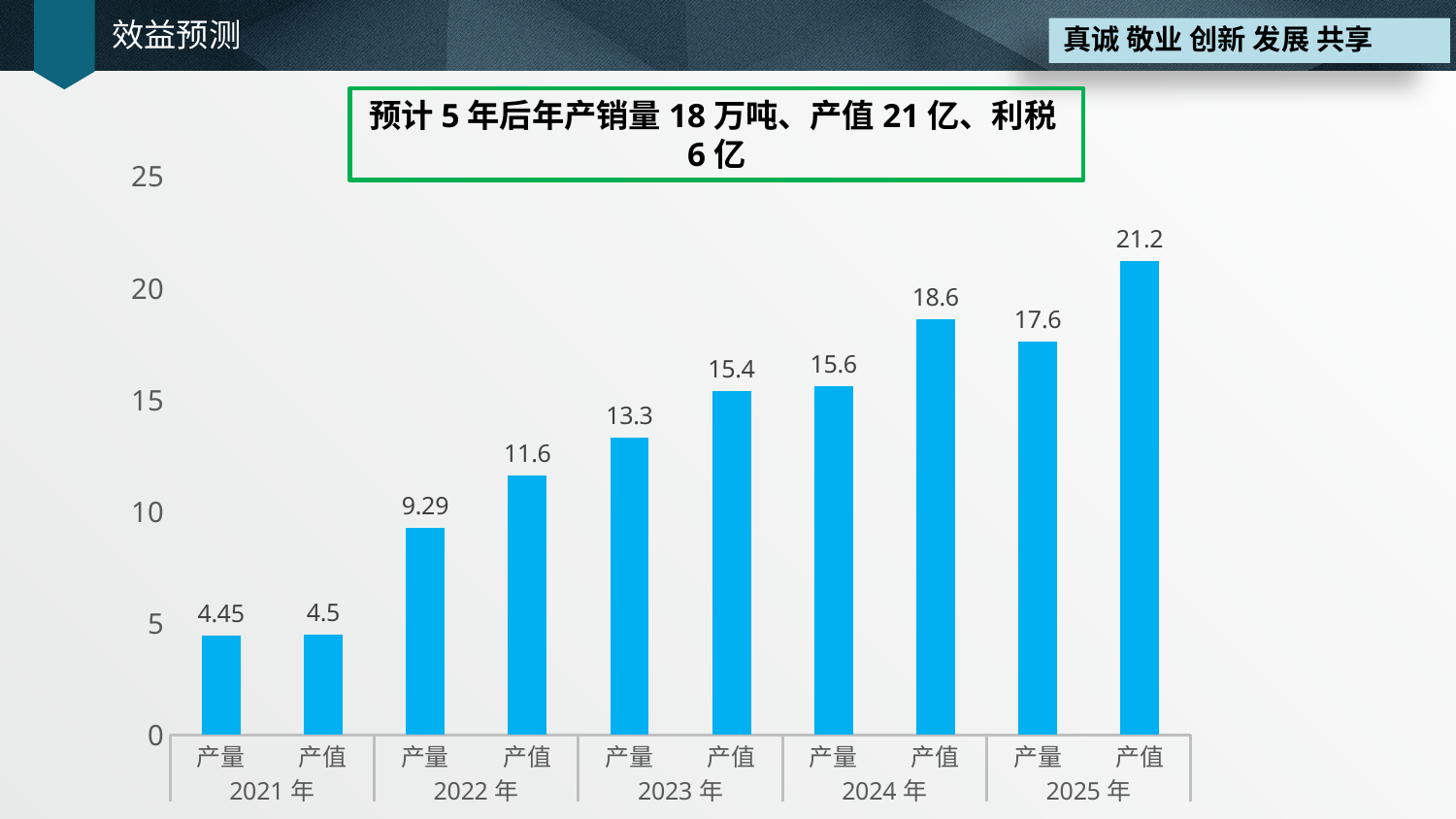
Which is larger, 产量 for 2025 年 or 产值 for 2024 年? 产值 for 2024 年 What is the value of 产值 for 2025 年? 21.2 Which bar has the highest value on the chart? 产值 2025 年 What type of chart is shown on the slide? bar chart Is the value of 产量 for 2023 年 greater or less than 15? less What is the value of 产量 for 2022 年? 9.29 What is the value of 产量 for 2021 年? 4.45 Which bar has the lowest value on the chart? 产量 2021 年 What is the difference between 产值 and 产量 for 2024 年? 3 What is the value of 产值 for 2023 年? 15.4 Do the 产值 values rise or fall from 2021 年 to 2025 年? rise How many bars are plotted on the chart? 10